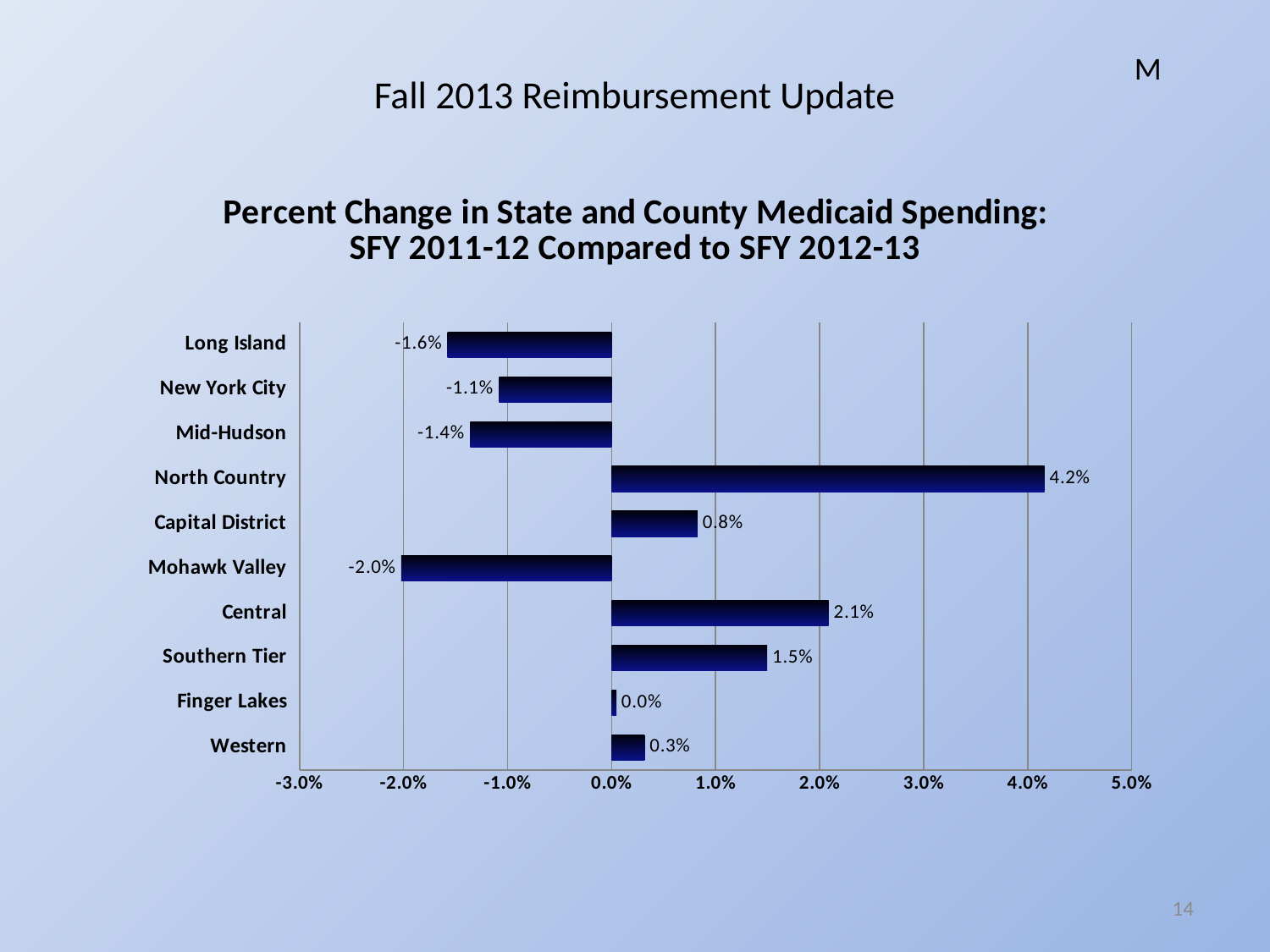
Which region has a larger percent change, Capital District or Western? Capital District What is the percent change in Medicaid spending for Southern Tier? 1.5% What is the percent change in Medicaid spending for North Country? 4.2% Which region has the lowest percent change in Medicaid spending? Mohawk Valley What is the percent change in Medicaid spending for Mohawk Valley? -2.0% What is the title of the chart? Percent Change in State and County Medicaid Spending: SFY 2011-12 Compared to SFY 2012-13 How many regions are shown in the chart? 10 What is the percent change in Medicaid spending for Long Island? -1.6% Which region has the highest percent change in Medicaid spending? North Country What is the difference between the percent change for North Country and Central? 2.1% What kind of chart is shown on the slide? Bar chart Is the value for Central greater or less than 1.0%? greater